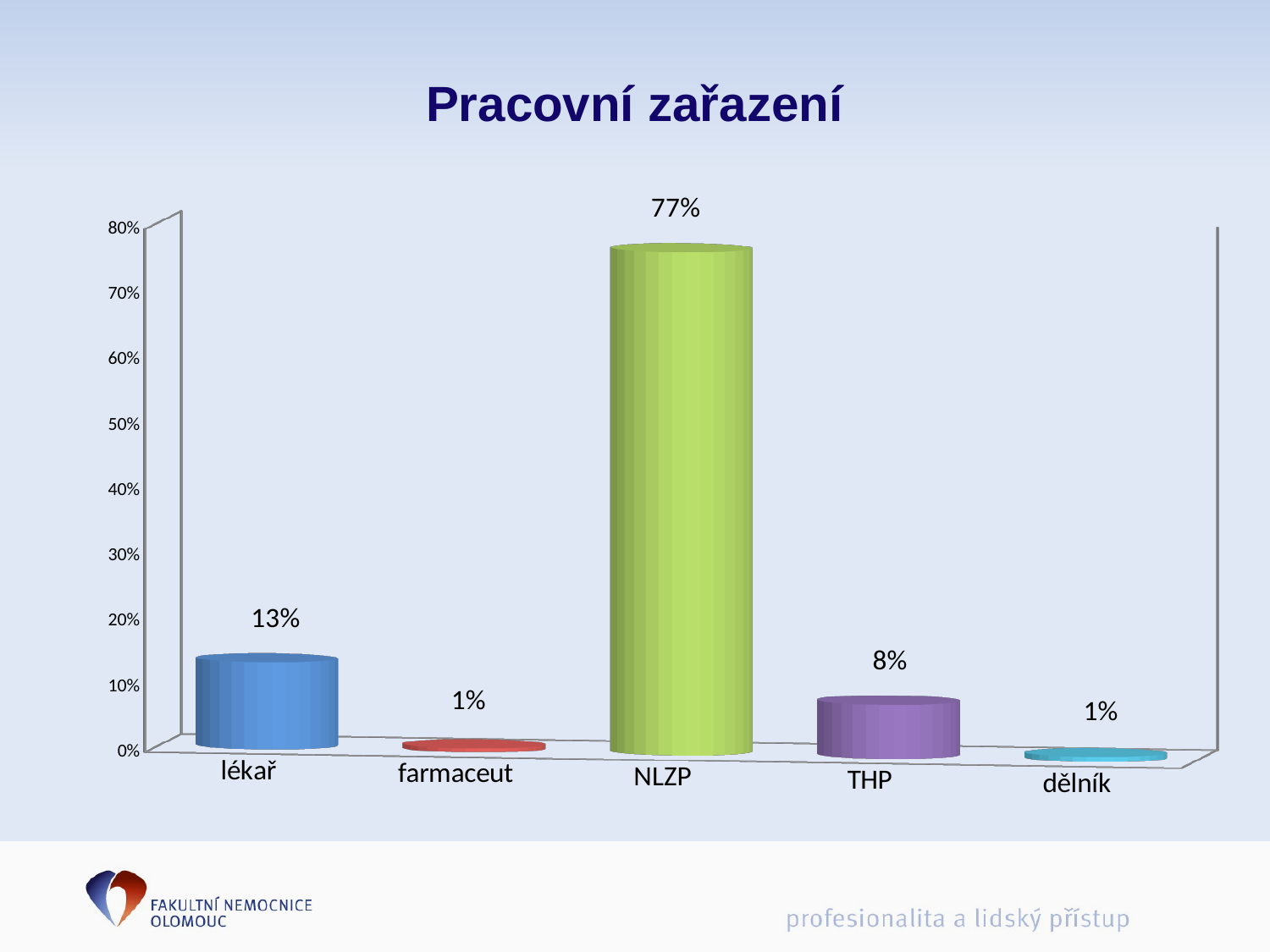
What is the value for THP? 8% What is the value for lékař? 13% Is the value for NLZP greater or less than 70%? greater What is the value for NLZP? 77% How many categories are shown on the x axis? 5 Which category has the highest value? NLZP What kind of chart is shown on the slide? bar chart What is the difference between the values for lékař and THP? 5% What is the value for farmaceut? 1% What is the difference between the values for NLZP and lékař? 64% Which is larger, the value for lékař or the value for THP? lékař What is the title of the chart? Pracovní zařazení